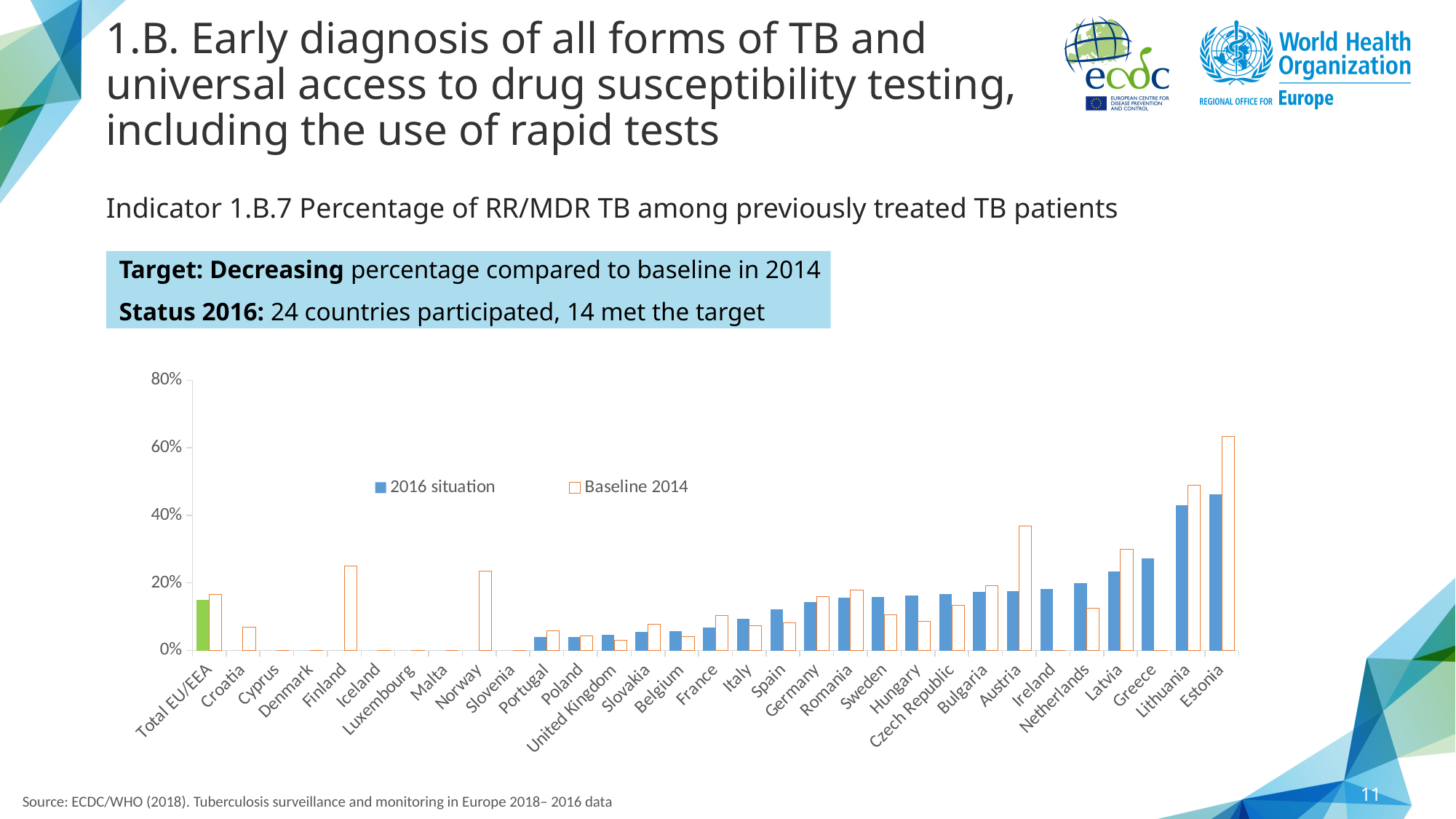
How many categories are shown along the x axis of the chart? 31 Which country has the highest 2016 situation value? Estonia How many series does the chart legend list? 2 Is the Baseline 2014 value for Austria greater or less than 40%? less Which country has the highest Baseline 2014 value? Estonia What are the two series named in the chart legend? 2016 situation and Baseline 2014 Is the Baseline 2014 value for Estonia greater or less than 60%? greater What kind of chart is shown on the slide? bar chart For the Netherlands, which is larger: the 2016 situation value or the Baseline 2014 value? 2016 situation For Austria, which is larger: the 2016 situation value or the Baseline 2014 value? Baseline 2014 Is the Baseline 2014 value for Finland greater or less than 20%? greater